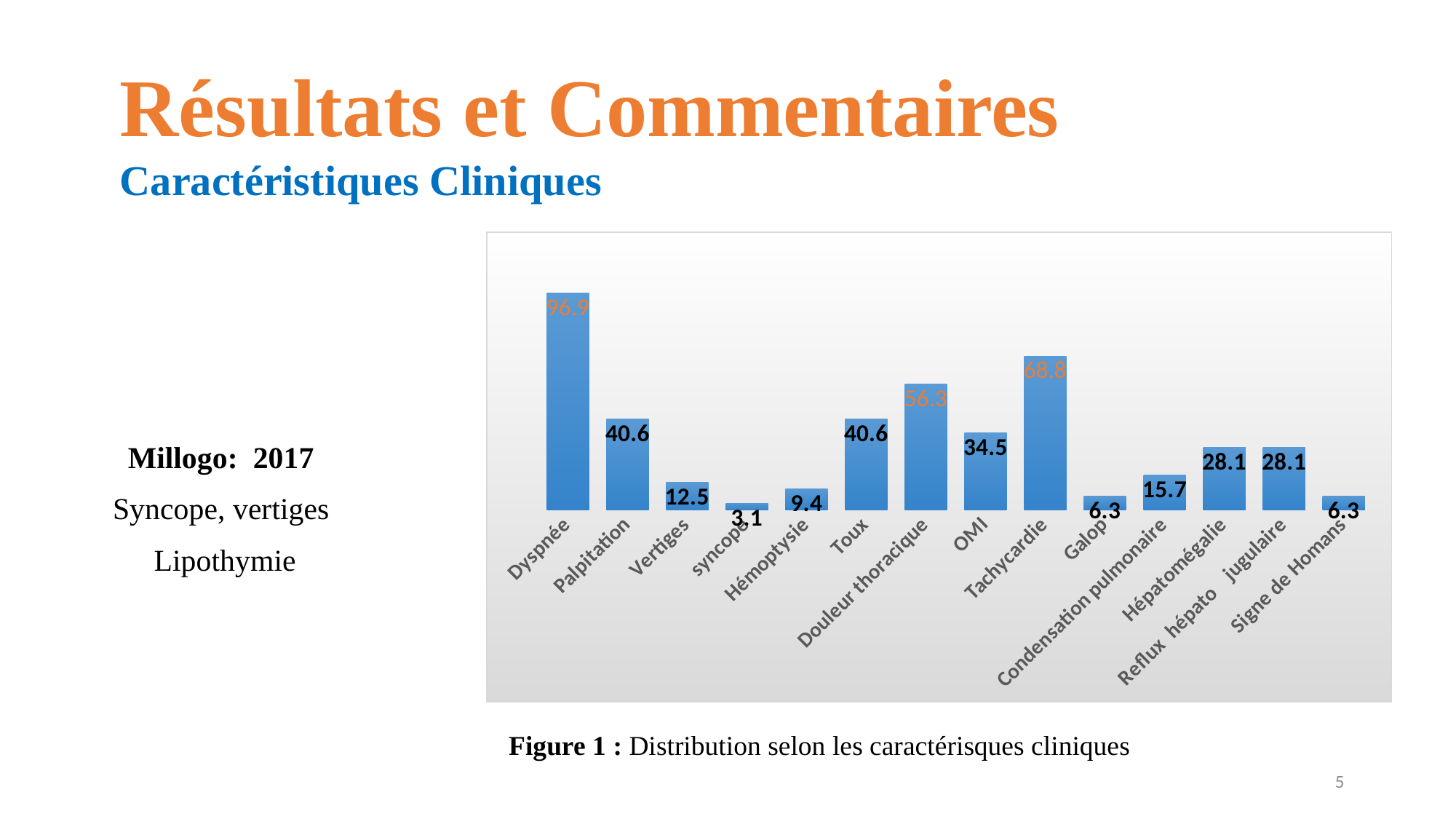
What is the value shown for Douleur thoracique? 56.3 What is the difference between the values for Douleur thoracique and OMI? 21.8 Which category has the lowest value? syncope What is the caption of the figure below the chart? Figure 1 : Distribution selon les caractérisques cliniques What is the value shown for Dyspnée? 96.9 What kind of chart is shown on the slide? Bar chart How many categories are shown in the chart? 14 What is the value shown for Condensation pulmonaire? 15.7 What is the difference between the values for Dyspnée and Tachycardie? 28.1 What is the value shown for Tachycardie? 68.8 Which is larger, the value for Vertiges or the value for Hémoptysie? Vertiges Which category has the highest value? Dyspnée